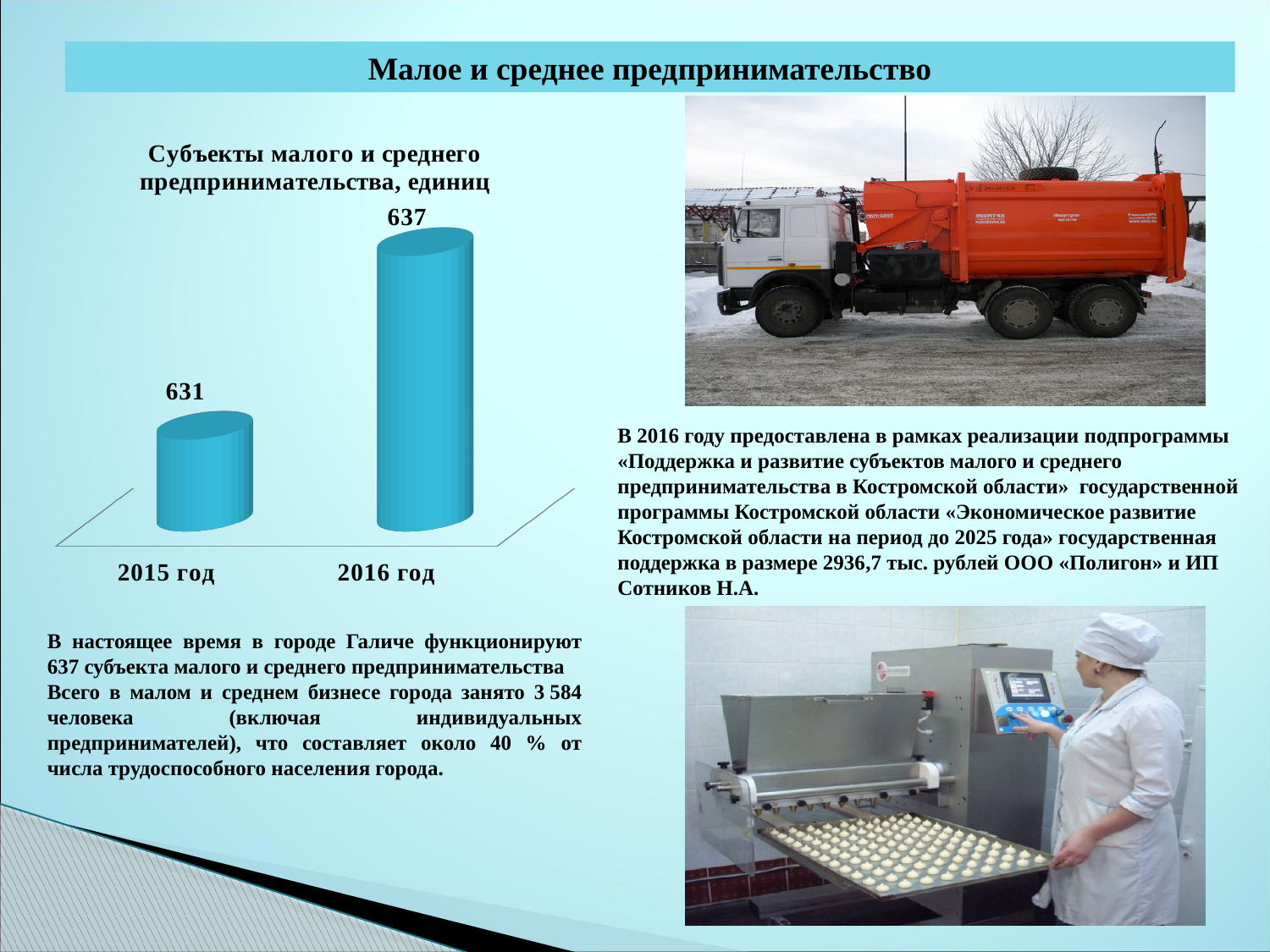
Which year has the lowest value in the chart? 2015 год What is the difference between the values for 2016 год and 2015 год? 6 What colour are the bars in the chart? blue Do the values rise or fall from 2015 год to 2016 год? rise What is the value for 2015 год in the chart? 631 Which is larger, the value for 2015 год or for 2016 год? 2016 год What kind of chart is shown on the slide? bar chart What is the title of the chart? Субъекты малого и среднего предпринимательства, единиц What is the value for 2016 год in the chart? 637 Which year has the highest value in the chart? 2016 год How many categories are shown in the chart? 2